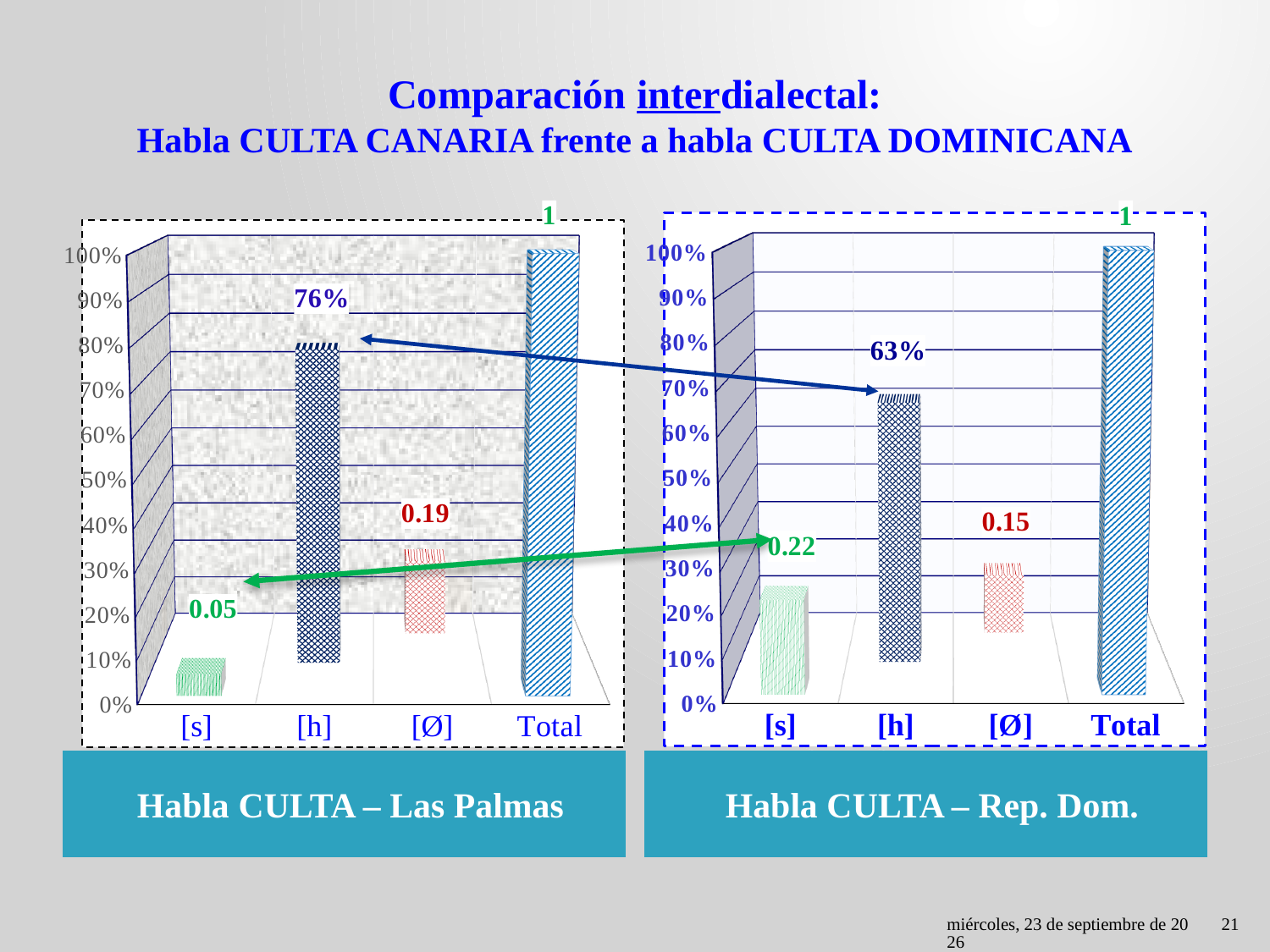
In the Habla CULTA – Las Palmas chart, what is the value for [s]? 0.05 Which is larger: the [Ø] value in the Las Palmas chart or the [Ø] value in the Rep. Dom. chart? Las Palmas In the Habla CULTA – Rep. Dom. chart, what is the value for [h]? 63% What is the difference between the [s] value in the Rep. Dom. chart and the [s] value in the Las Palmas chart? 0.17 In the Habla CULTA – Rep. Dom. chart, what is the value for [Ø]? 0.15 What is the difference between the [h] value in the Las Palmas chart and the [h] value in the Rep. Dom. chart? 13% What kind of chart is the Habla CULTA – Rep. Dom. chart? bar chart How many categories are shown on the x axis of the Habla CULTA – Las Palmas chart? 4 In the Habla CULTA – Rep. Dom. chart, is the value for [s] greater or less than 30%? less In the Habla CULTA – Las Palmas chart, which category has the lowest value? [s] In the Habla CULTA – Rep. Dom. chart, which category has the highest value? Total In the Habla CULTA – Las Palmas chart, what is the value for [h]? 76%